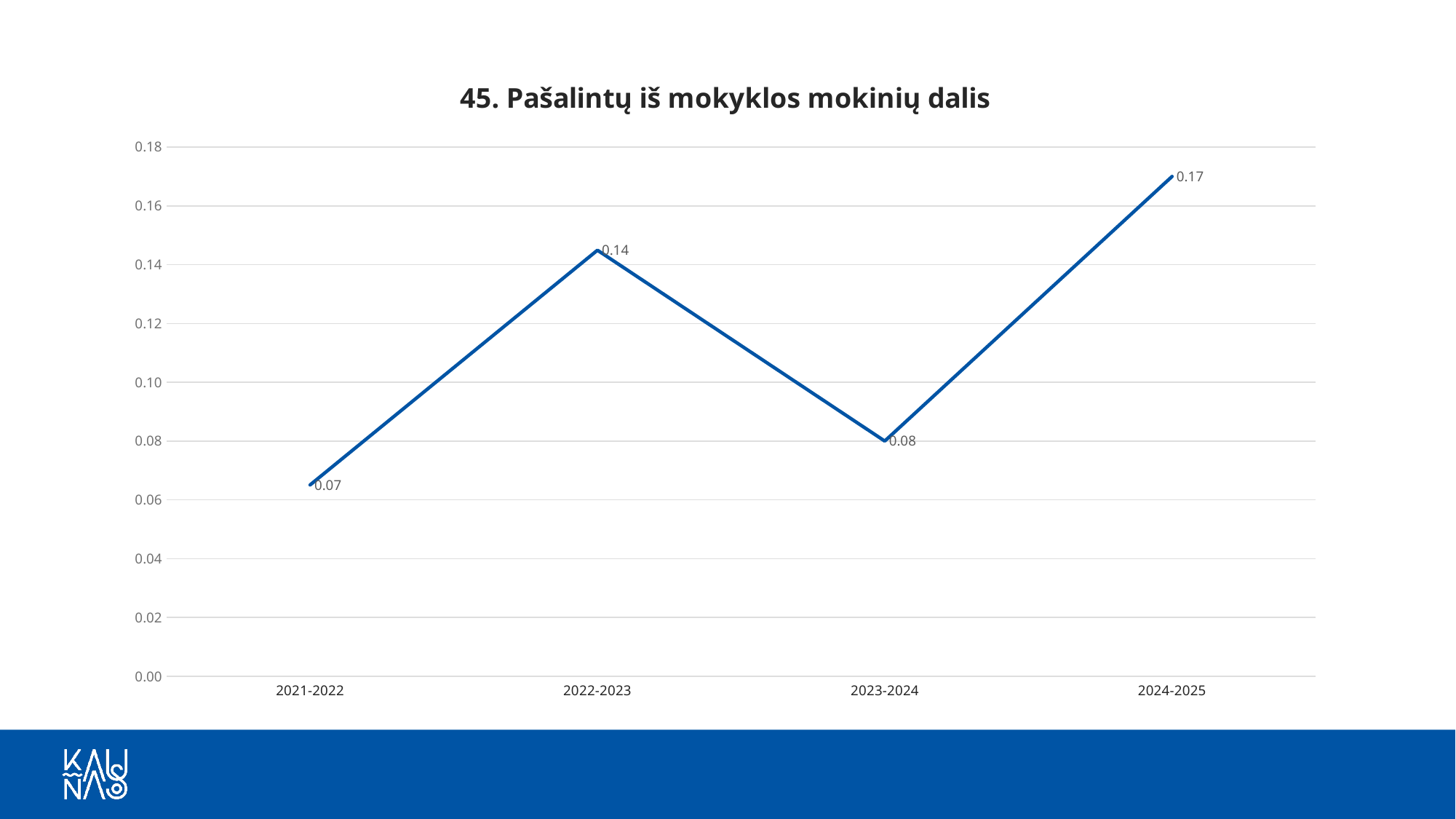
What is the title of the chart? 45. Pašalintų iš mokyklos mokinių dalis What kind of chart is shown on the slide? line chart Is the value for 2024-2025 greater or less than 0.16? greater Which is larger, the value for 2022-2023 or the value for 2023-2024? 2022-2023 What is the difference between the values for 2024-2025 and 2021-2022? 0.10 What is the value for 2024-2025? 0.17 What is the value for 2022-2023? 0.14 How many school years are plotted on the chart? 4 Which school year has the lowest value? 2021-2022 What is the value for 2023-2024? 0.08 Which school year has the highest value? 2024-2025 What is the value for 2021-2022? 0.07